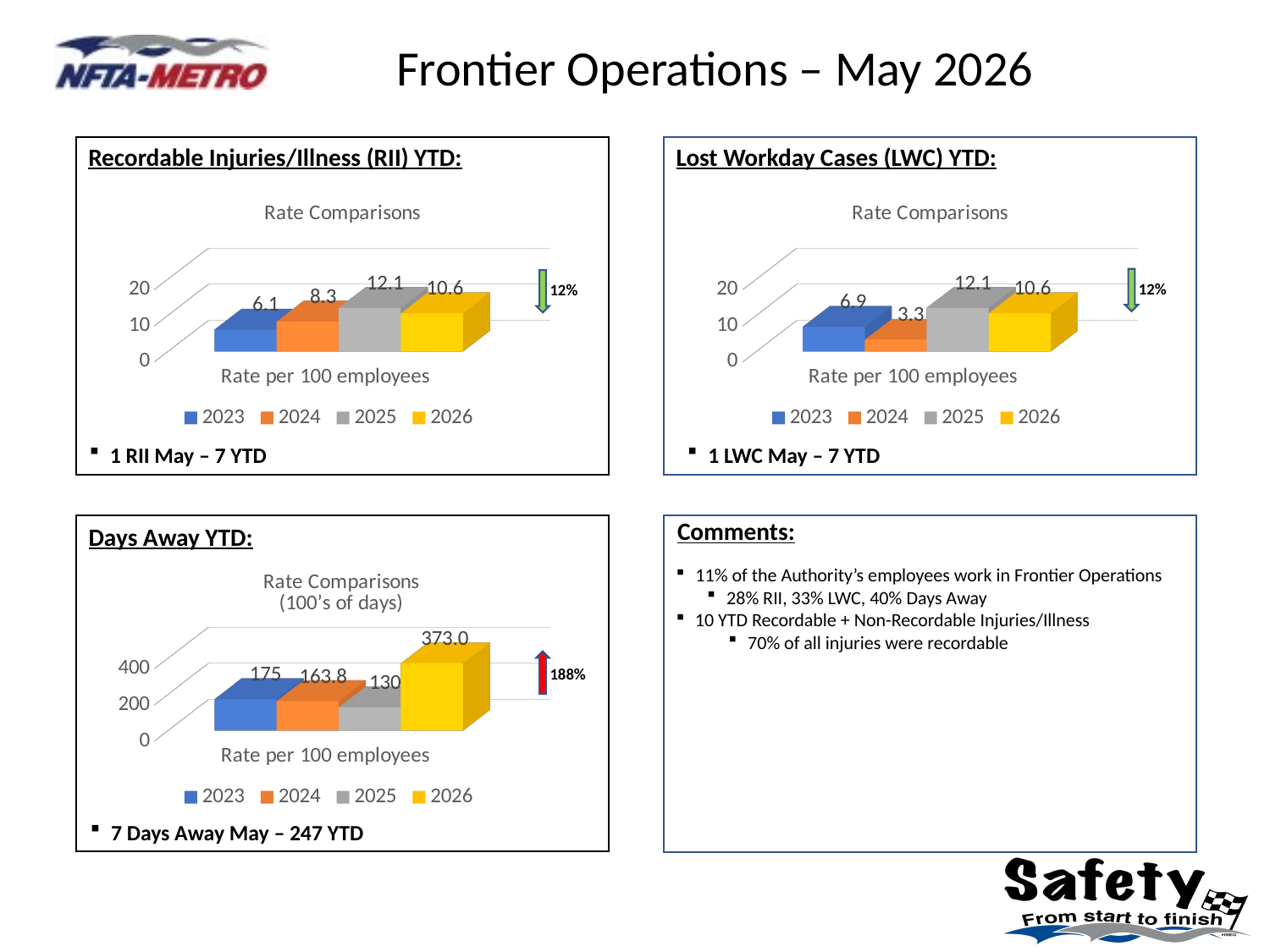
In the Recordable Injuries/Illness (RII) YTD chart, what is the difference between the 2025 and 2026 values? 1.5 In the Days Away YTD chart, what is the difference between the 2023 and 2024 values? 11.2 What is the title of the chart in the Days Away YTD box? Rate Comparisons (100's of days) In the Lost Workday Cases (LWC) YTD chart, is the value for 2023 larger or smaller than the value for 2026? smaller In the Lost Workday Cases (LWC) YTD chart, which year has the lowest rate? 2024 In the Lost Workday Cases (LWC) YTD chart, what is the value for 2024? 3.3 In the Days Away YTD chart, which year has the lowest value? 2025 In the Days Away YTD chart, what is the value for 2026? 373.0 In the Recordable Injuries/Illness (RII) YTD chart, what is the value for 2024? 8.3 In the Recordable Injuries/Illness (RII) YTD chart, which year has the highest rate? 2025 How many series does the legend of the Days Away YTD chart list? 4 What kind of chart is the Lost Workday Cases (LWC) YTD chart? bar chart